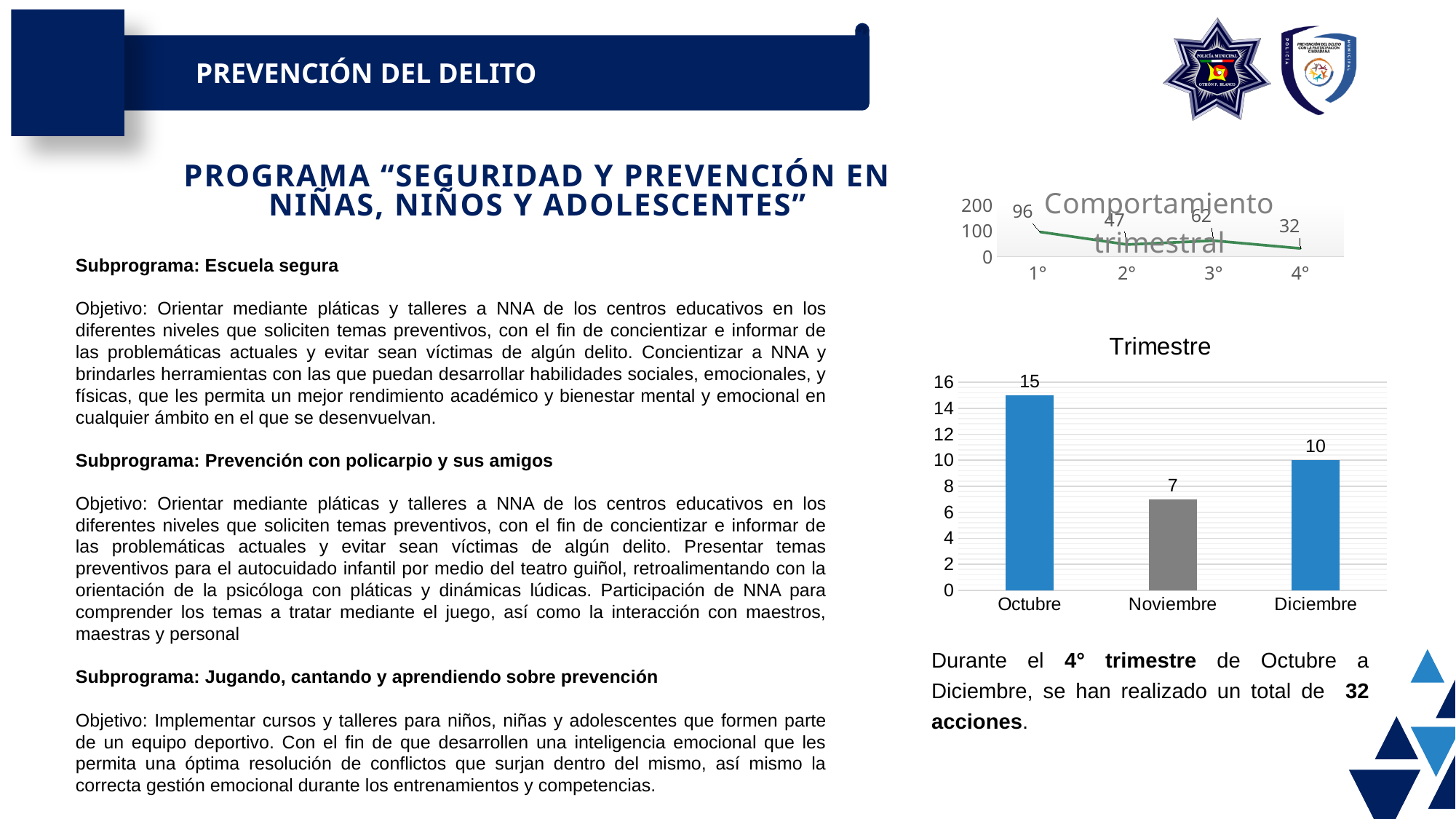
In the "Trimestre" chart, which month has the highest value? Octubre In the "Comportamiento trimestral" chart, what is the value for 3°? 62 What kind of chart is the "Comportamiento trimestral" chart? Line chart In the "Trimestre" chart, which month has the lowest value? Noviembre In the "Trimestre" chart, what is the value for Octubre? 15 In the "Trimestre" chart, what is the value for Noviembre? 7 What kind of chart is the "Trimestre" chart? Bar chart In the "Trimestre" chart, how many months are shown? 3 In the "Trimestre" chart, what is the difference between the values for Octubre and Diciembre? 5 In the "Trimestre" chart, which is larger, the value for Noviembre or the value for Diciembre? Diciembre In the "Comportamiento trimestral" chart, which quarter has the lowest value? 4° In the "Comportamiento trimestral" chart, what is the value for 1°? 96